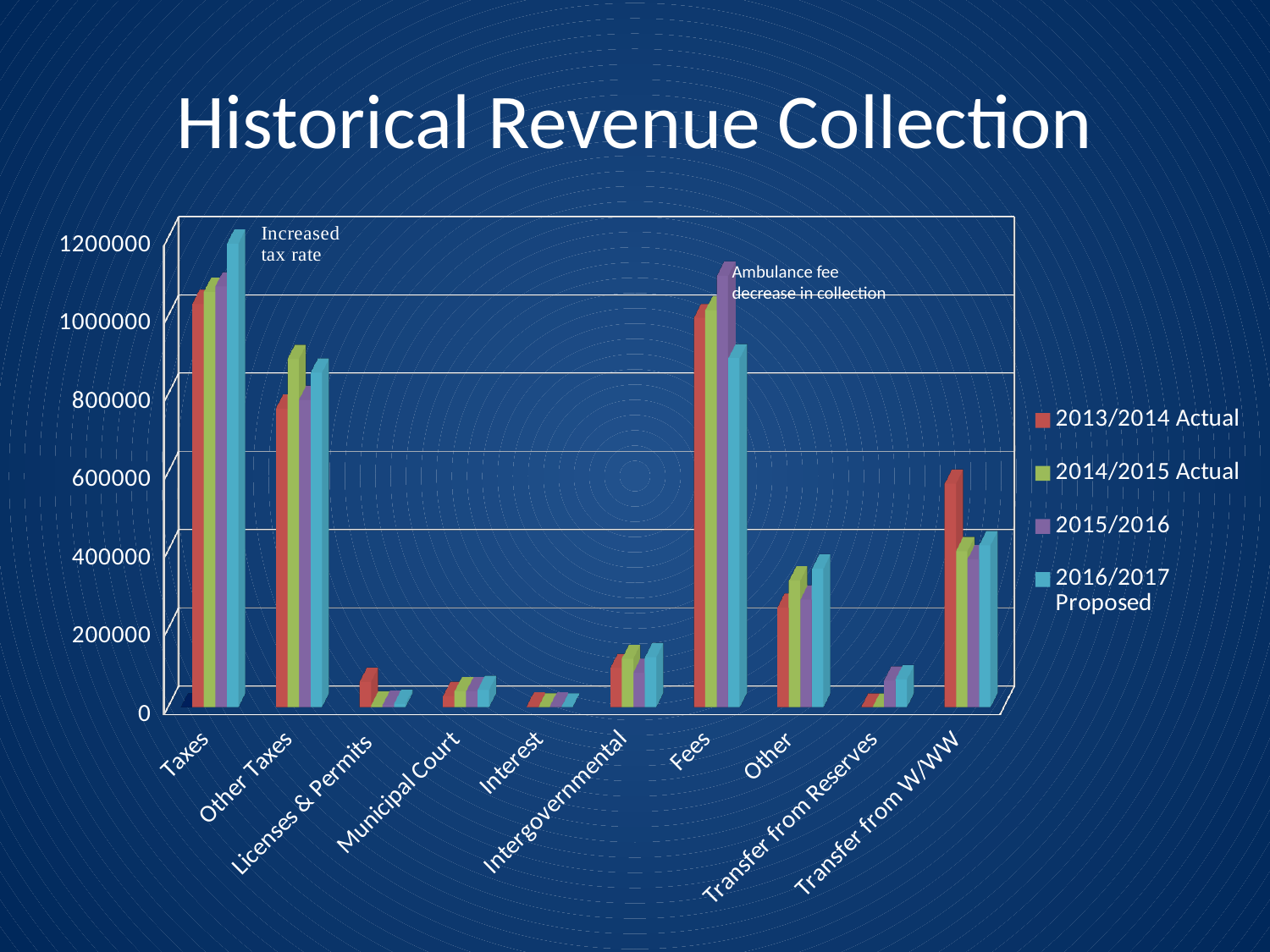
What is the title of the chart? Historical Revenue Collection How many revenue categories are shown on the x axis? 10 Is the 2016/2017 Proposed value for Taxes greater or less than 1000000? greater Is the 2013/2014 Actual value for Transfer from W/WW greater or less than 400000? greater For Fees, which is larger: the 2015/2016 value or the 2016/2017 Proposed value? 2015/2016 Which series is shown in light blue in the legend? 2016/2017 Proposed For Taxes, which is larger: the 2013/2014 Actual value or the 2016/2017 Proposed value? 2016/2017 Proposed What kind of chart is shown on the slide? Bar chart Which category has the highest 2016/2017 Proposed value? Taxes Is the 2015/2016 value for Fees greater or less than 1000000? greater How many series does the legend list? 4